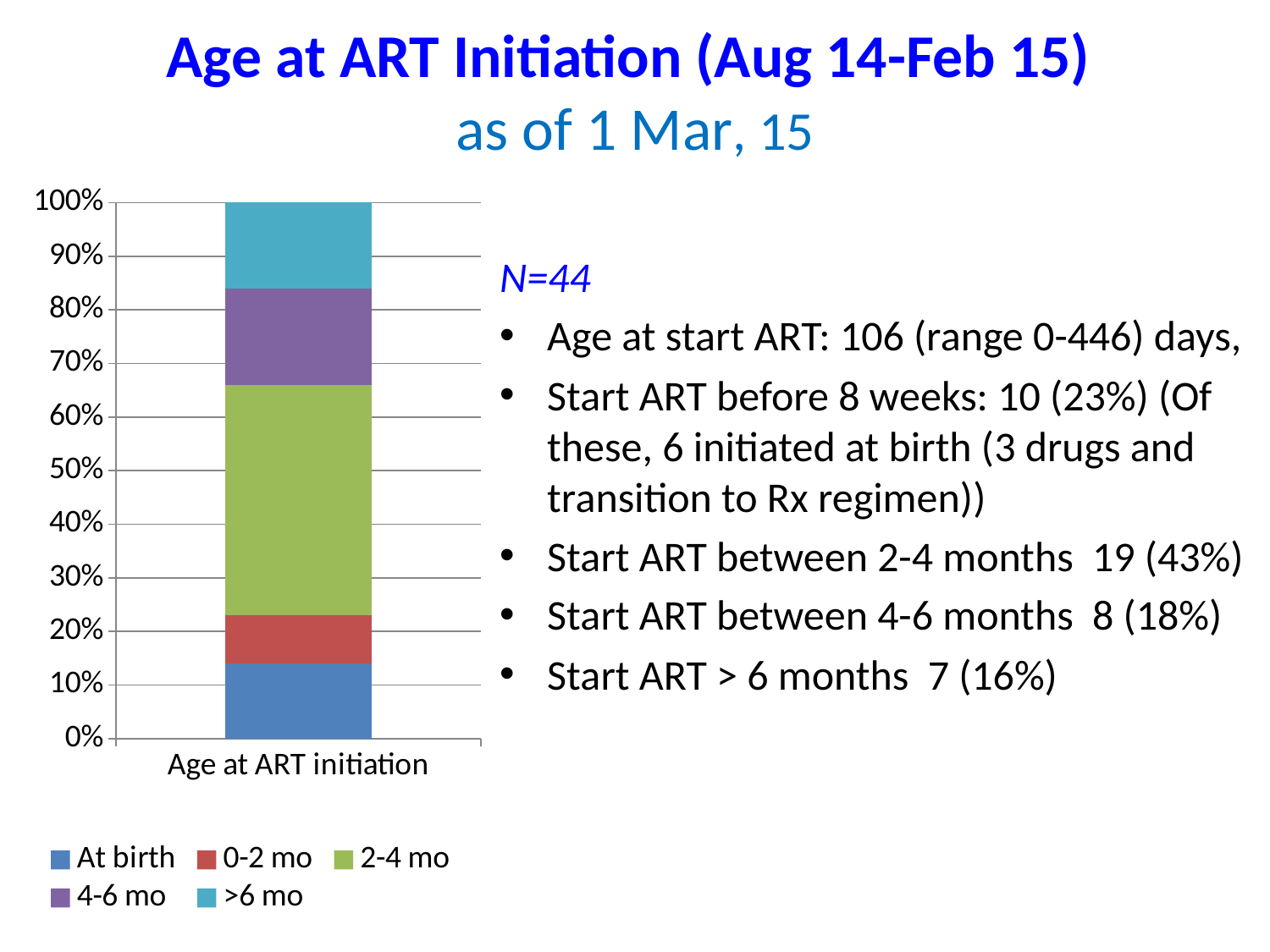
What is the total height of the stacked bar as read from the y axis? 100% Which series takes up the largest segment of the stacked bar? 2-4 mo Is the share of the bar for At birth greater or less than 20%? less Which segment is larger in the stacked bar, 2-4 mo or 4-6 mo? 2-4 mo Which series takes up the smallest segment of the stacked bar? 0-2 mo How many series does the chart legend list? 5 How many categories are plotted on the x axis of the chart? 1 What is the category label shown on the x axis of the chart? Age at ART initiation Is the share of the bar for 2-4 mo greater or less than 30%? greater What colour represents the 2-4 mo series in the chart legend? Green What kind of chart is shown on the slide? Stacked bar chart Is the share of the bar for >6 mo greater or less than 30%? less